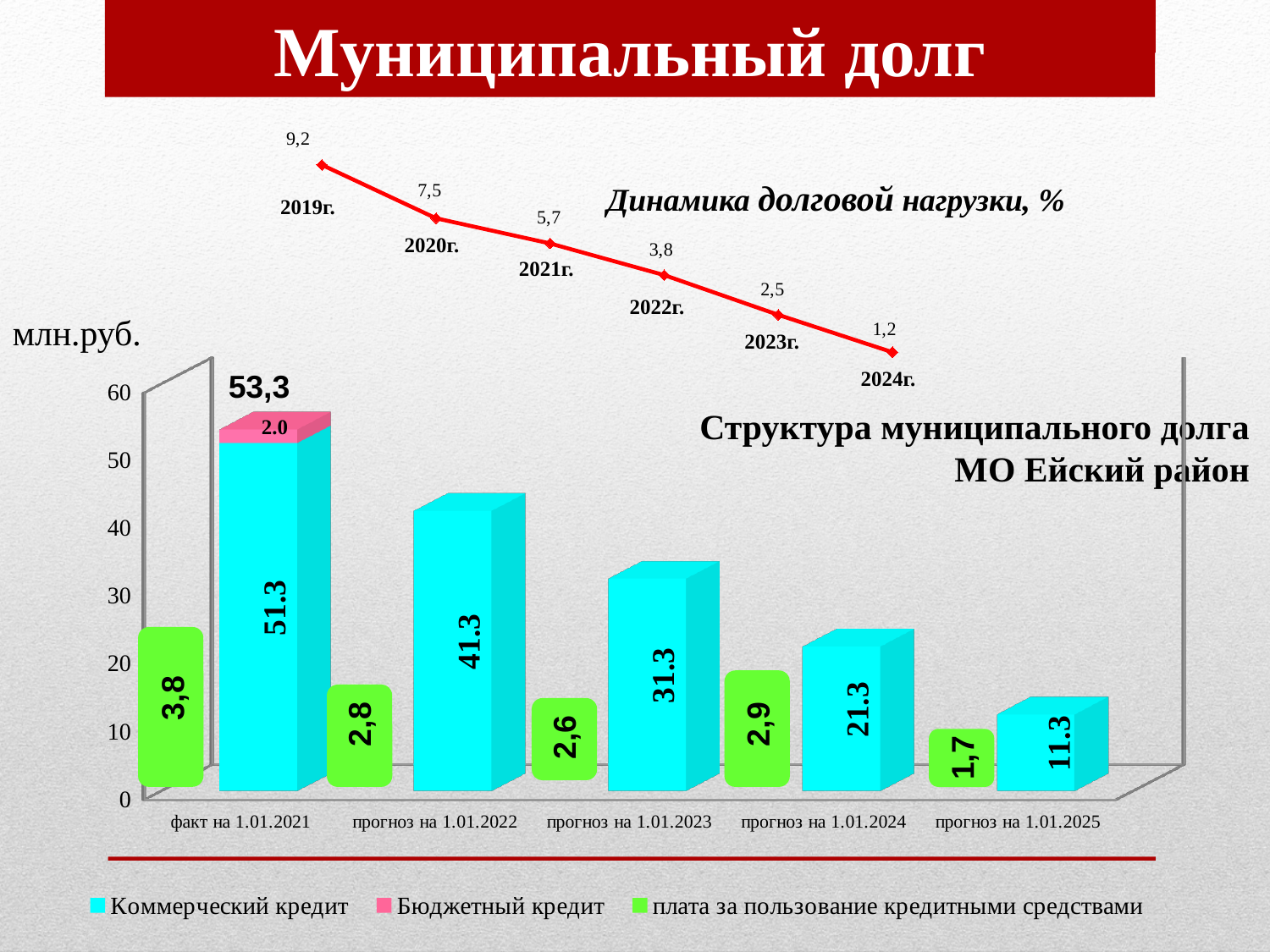
In the bar chart 'Структура муниципального долга МО Ейский район', what is the value of Бюджетный кредит for факт на 1.01.2021? 2.0 In the bar chart 'Структура муниципального долга МО Ейский район', what is the total of the stacked bar for факт на 1.01.2021? 53,3 In the bar chart 'Структура муниципального долга МО Ейский район', how many series does the legend list? 3 In the line chart 'Динамика долговой нагрузки, %', what is the value for 2024г.? 1,2 In the line chart 'Динамика долговой нагрузки, %', how many data points are plotted? 6 What kind of chart is 'Структура муниципального долга МО Ейский район'? bar chart In the line chart 'Динамика долговой нагрузки, %', what is the value for 2019г.? 9,2 In the bar chart 'Структура муниципального долга МО Ейский район', which category has the lowest value of плата за пользование кредитными средствами? прогноз на 1.01.2025 In the line chart 'Динамика долговой нагрузки, %', what is the difference between the 2020г. and 2021г. values? 1,8 In the bar chart 'Структура муниципального долга МО Ейский район', what is the difference between Коммерческий кредит for прогноз на 1.01.2022 and прогноз на 1.01.2024? 20 In the line chart 'Динамика долговой нагрузки, %', do the values rise or fall from 2019г. to 2024г.? fall In the bar chart 'Структура муниципального долга МО Ейский район', what is the value of Коммерческий кредит for прогноз на 1.01.2023? 31.3